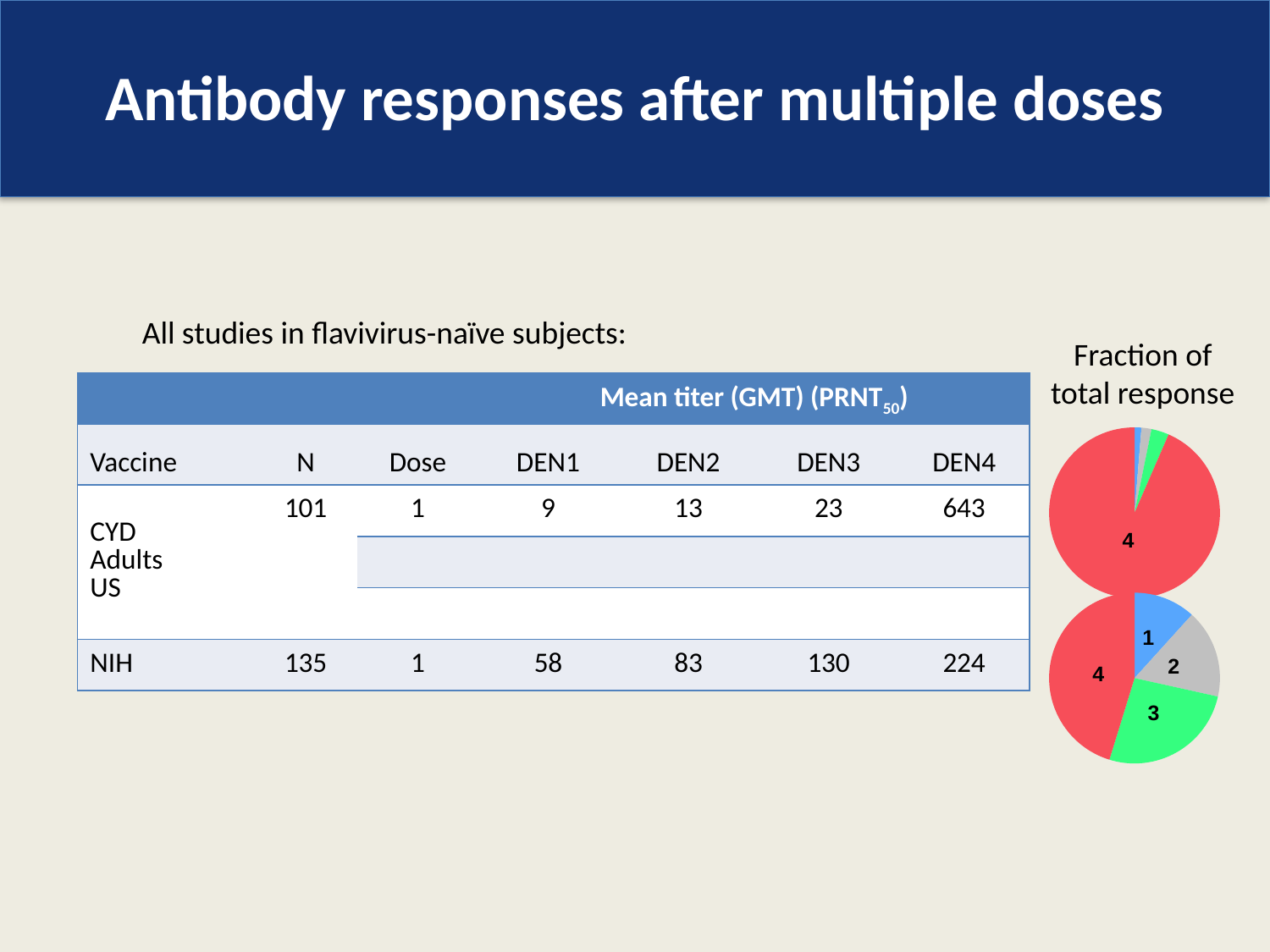
In the bottom pie chart, which slice is larger, 4 or 2? 4 In the top pie chart, which slice is larger, 4 or 3? 4 What kind of charts are shown under the heading "Fraction of total response"? Pie charts In the bottom pie chart, which labelled slice is the largest? 4 In the top pie chart, which labelled slice is the largest? 4 What heading appears above the pie charts on the right of the slide? Fraction of total response In the bottom pie chart, which slice is larger, 4 or 3? 4 How many pie charts are shown on the slide? 2 In the bottom pie chart, how many slices are labelled? 4 What colour is slice 4 in the pie charts? Red